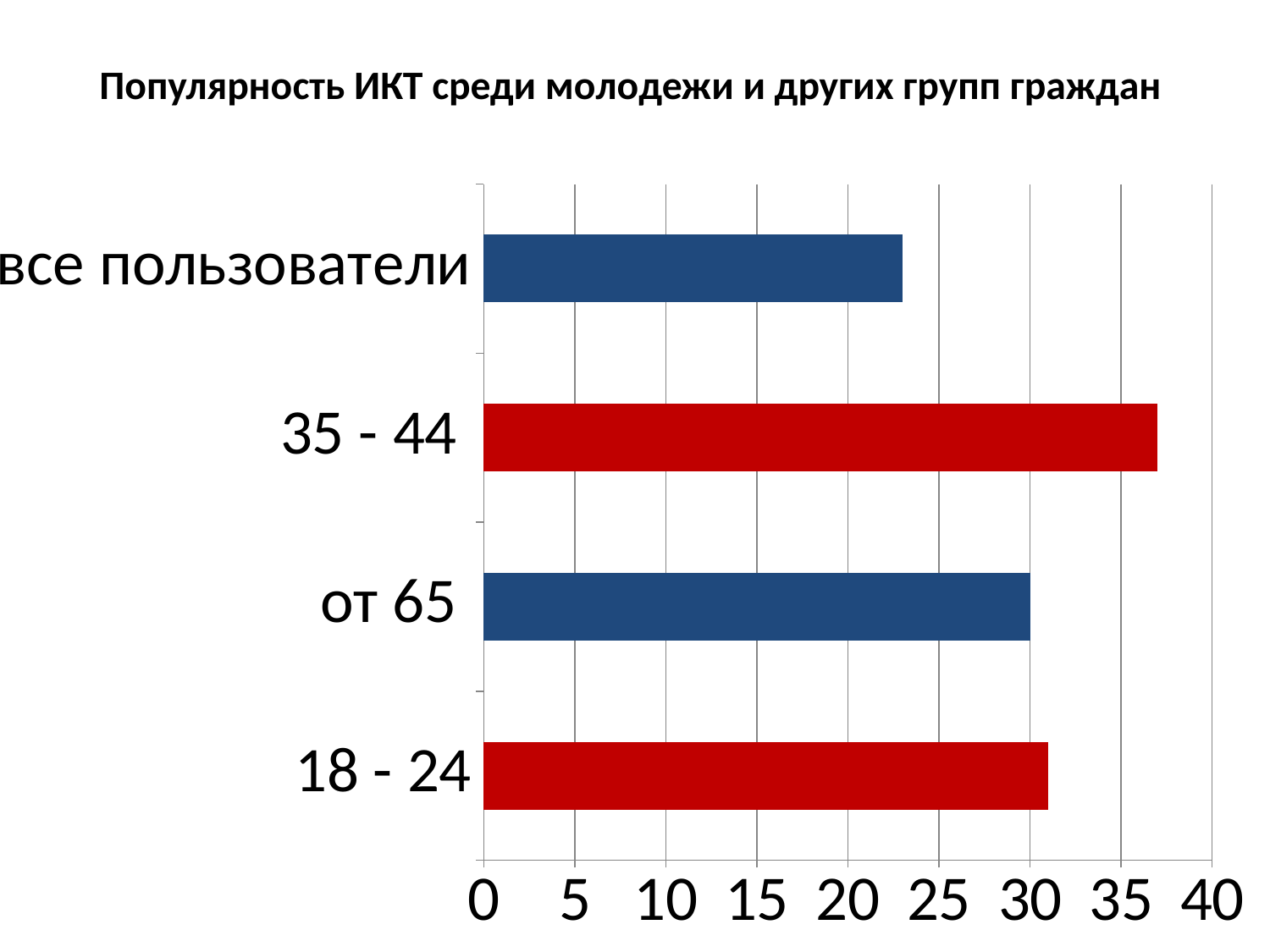
What is the title of the chart? Популярность ИКТ среди молодежи и других групп граждан What kind of chart is shown on the slide? bar chart Which is larger, the value for "35 - 44" or the value for "18 - 24"? 35 - 44 Which category has the highest value? 35 - 44 Is the value for "35 - 44" greater or less than 35? greater Is the value for "18 - 24" greater or less than 25? greater Which is larger, the value for "от 65" or the value for "все пользователи"? от 65 What is the value for "от 65"? 30 What colour is the bar for "35 - 44"? red Is the value for "все пользователи" greater or less than 25? less Which category has the lowest value? все пользователи How many categories are plotted in the chart? 4